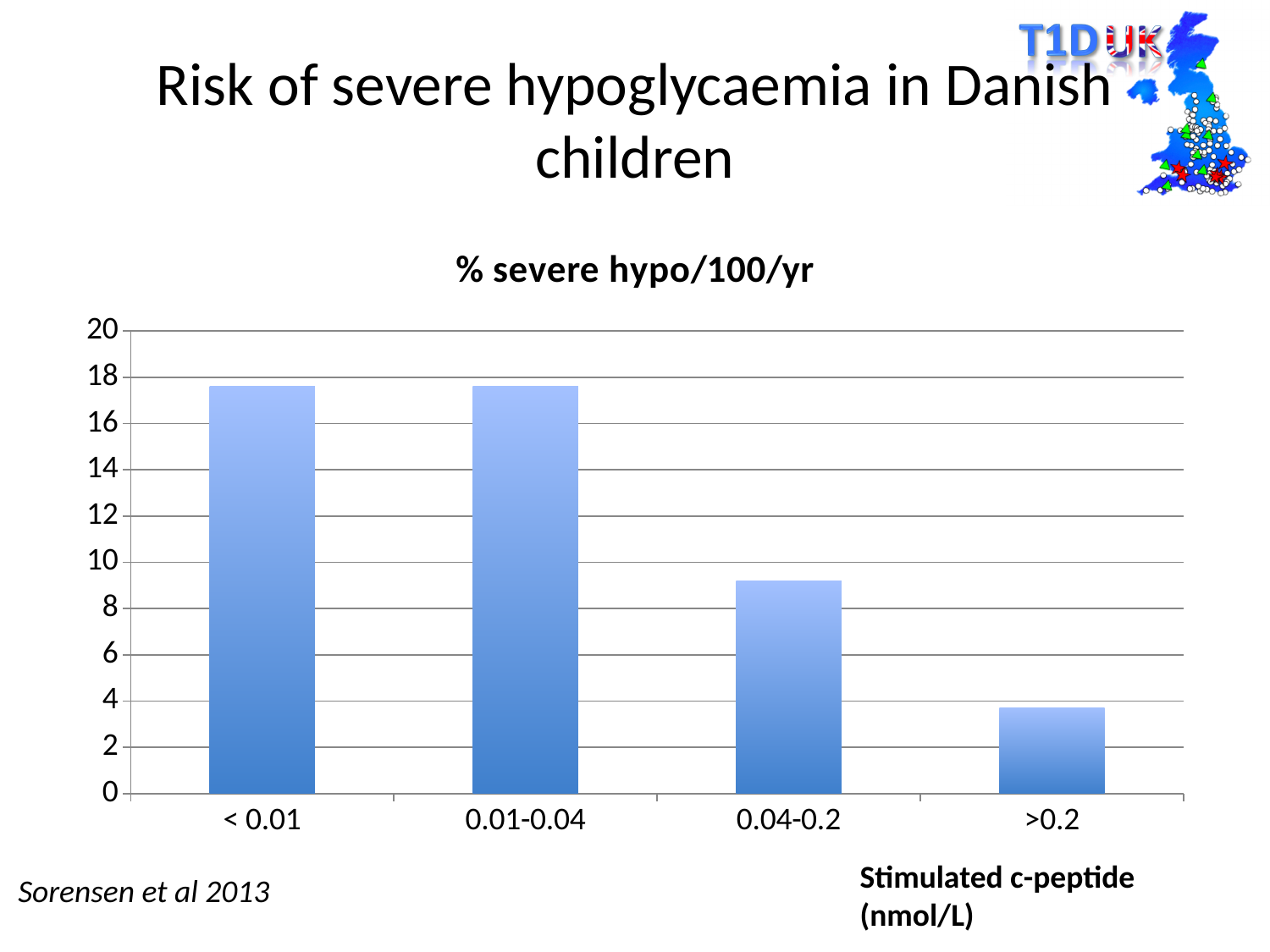
Which stimulated c-peptide category has the lowest % severe hypo/100/yr? >0.2 Is the value for the < 0.01 category greater or less than 16? greater Is the value for the 0.01-0.04 category greater or less than 14? greater What is the title of the chart? % severe hypo/100/yr Is the value for the 0.04-0.2 category greater or less than 8? greater Which has the larger value, the 0.04-0.2 category or the >0.2 category? 0.04-0.2 Which has the larger value, the 0.01-0.04 category or the 0.04-0.2 category? 0.01-0.04 How many c-peptide categories are plotted on the chart? 4 Do the values rise or fall as stimulated c-peptide increases along the x axis? fall What kind of chart is shown on the slide? bar chart